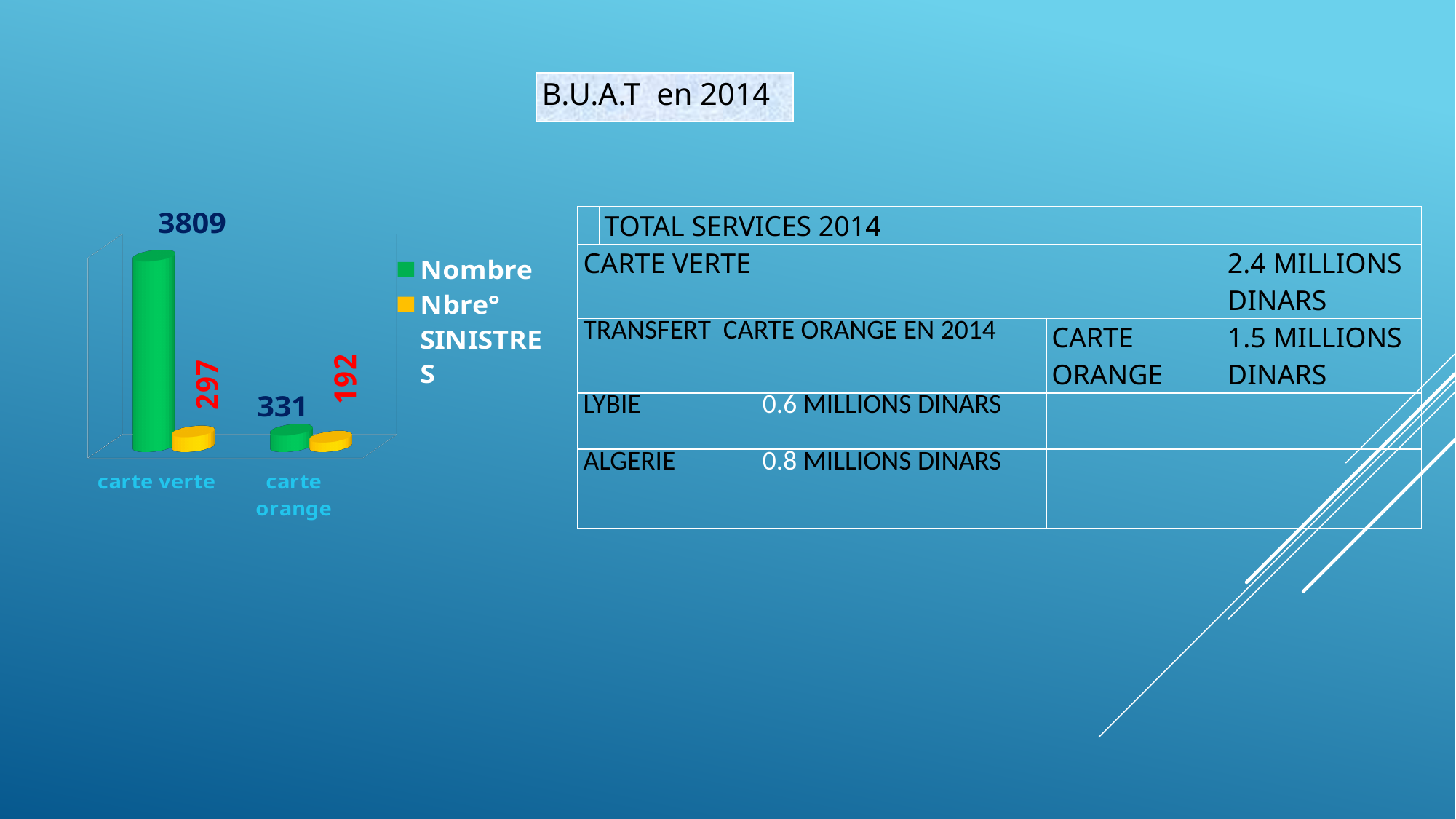
How many categories are shown on the x axis of the chart? 2 What is the Nbre° SINISTRES value for carte orange? 192 What is the Nombre value for carte verte? 3809 What kind of chart is shown on the slide? bar chart What is the Nbre° SINISTRES value for carte verte? 297 What is the Nombre value for carte orange? 331 Which category has the lowest Nbre° SINISTRES value? carte orange What is the difference between the Nbre° SINISTRES values for carte verte and carte orange? 105 Which category has the highest Nombre value? carte verte What is the difference between the Nombre values for carte verte and carte orange? 3478 How many series does the chart legend list? 2 Which is larger: the Nombre value for carte orange or the Nbre° SINISTRES value for carte verte? Nombre value for carte orange